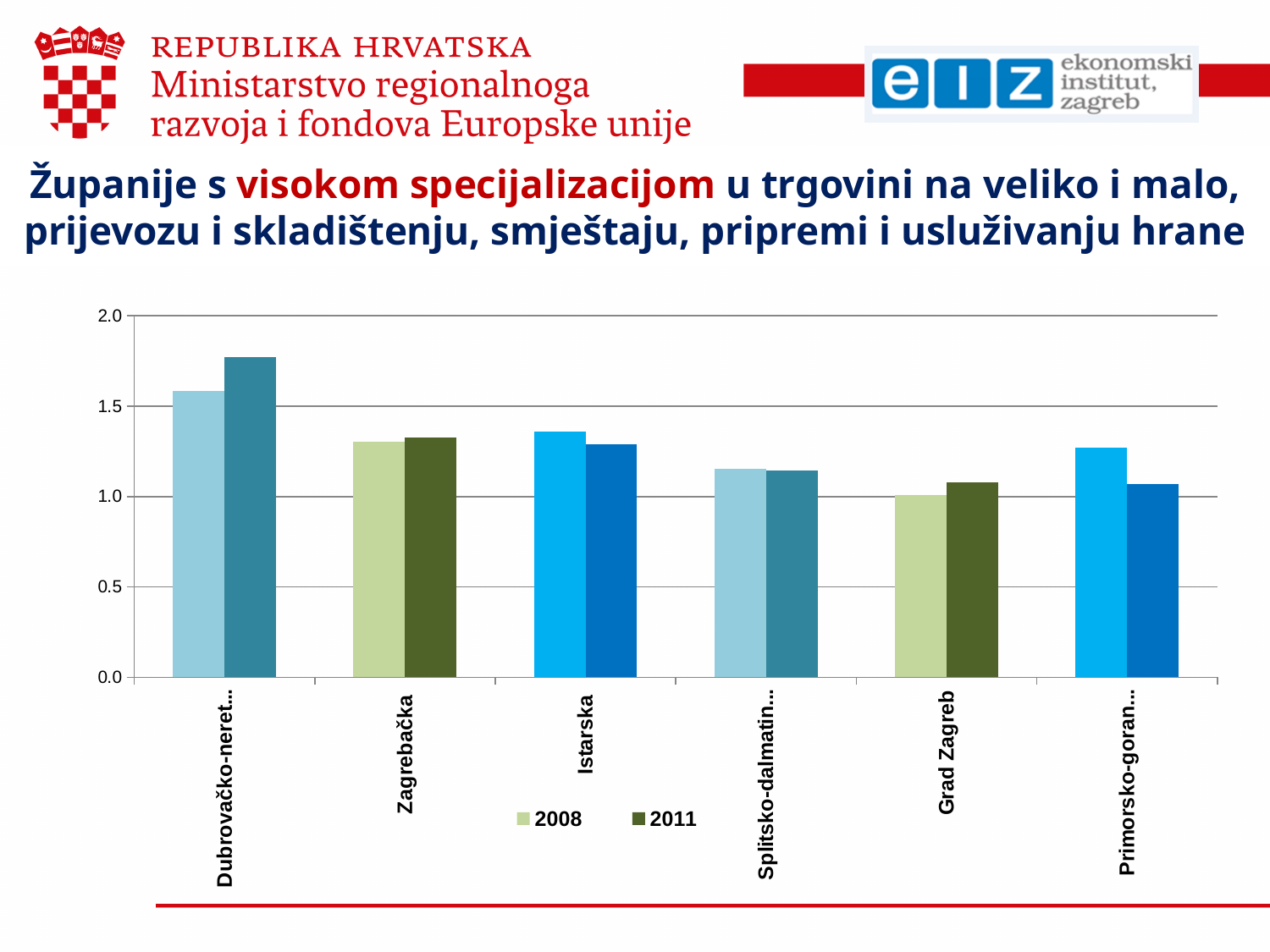
How many series does the chart legend list? 2 How many categories (counties) are shown on the x axis of the chart? 6 Is the 2011 value for Grad Zagreb greater or less than 1.0? greater Which years are listed in the chart legend? 2008 and 2011 What kind of chart is shown on the slide? bar chart Is the 2011 value for Zagrebačka greater or less than 1.5? less For Istarska, which year has the larger value, 2008 or 2011? 2008 Is the 2008 value for Istarska greater or less than 1.0? greater Which category has the lowest 2008 value? Grad Zagreb For Grad Zagreb, which year has the larger value, 2008 or 2011? 2011 Which has the larger 2011 value, Istarska or Grad Zagreb? Istarska